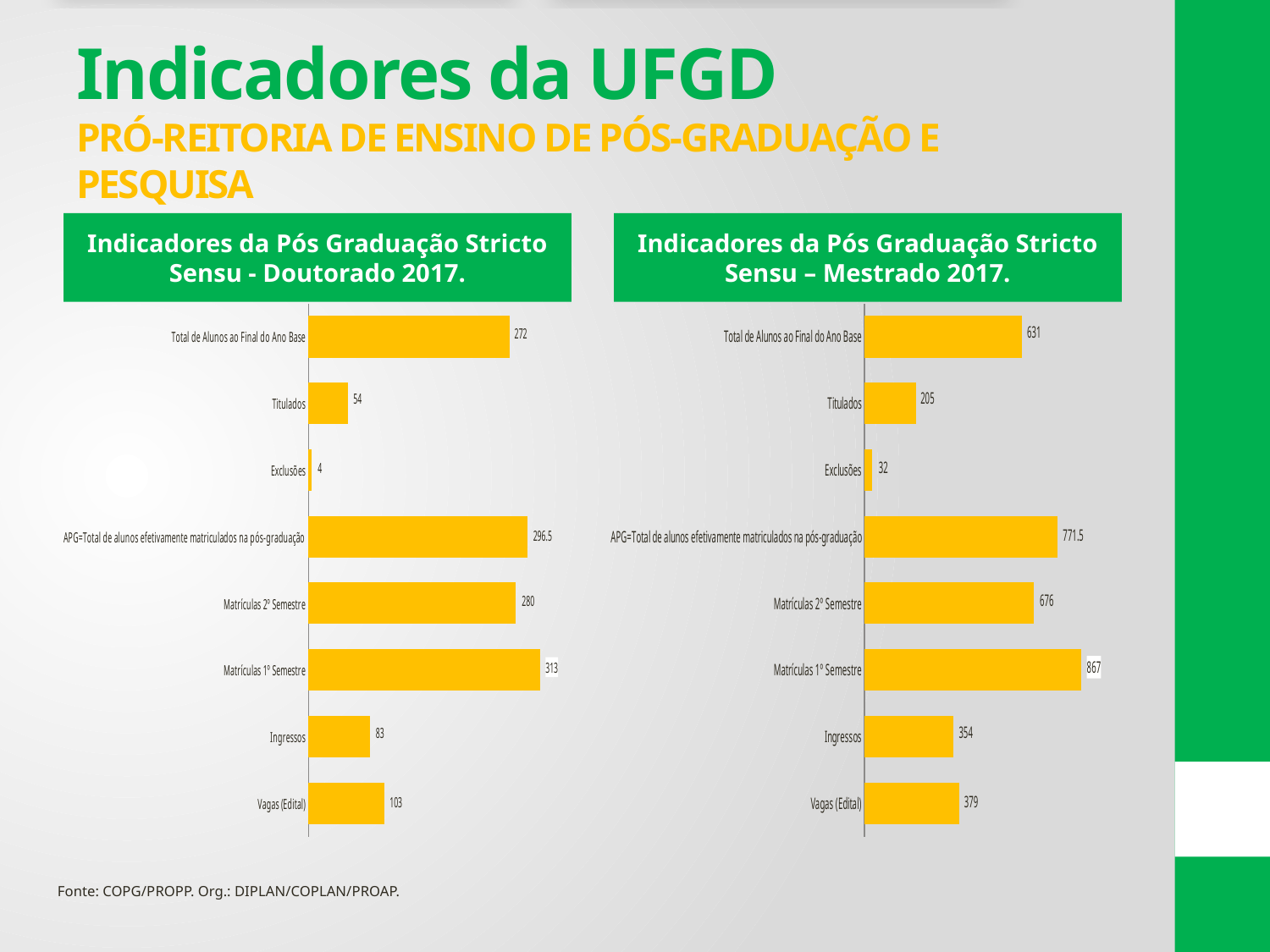
How many categories does the Doutorado 2017 chart show? 8 In the Mestrado 2017 chart, what is the value for Matrículas 1º Semestre? 867 What is the title of the chart on the left side of the slide? Indicadores da Pós Graduação Stricto Sensu - Doutorado 2017. In the Doutorado 2017 chart, which category has the highest value? Matrículas 1º Semestre In the Doutorado 2017 chart, which is larger: Matrículas 2º Semestre or Total de Alunos ao Final do Ano Base? Matrículas 2º Semestre In the Mestrado 2017 chart, which category has the lowest value? Exclusões In the Mestrado 2017 chart, what is the difference between Total de Alunos ao Final do Ano Base and Titulados? 426 In the Mestrado 2017 chart, what is the value for APG=Total de alunos efetivamente matriculados na pós-graduação? 771.5 In the Doutorado 2017 chart, what is the value for Titulados? 54 In the Mestrado 2017 chart, which is larger: Ingressos or Vagas (Edital)? Vagas (Edital) In the Doutorado 2017 chart, what is the difference between Vagas (Edital) and Ingressos? 20 What kind of chart is the Mestrado 2017 chart? Bar chart